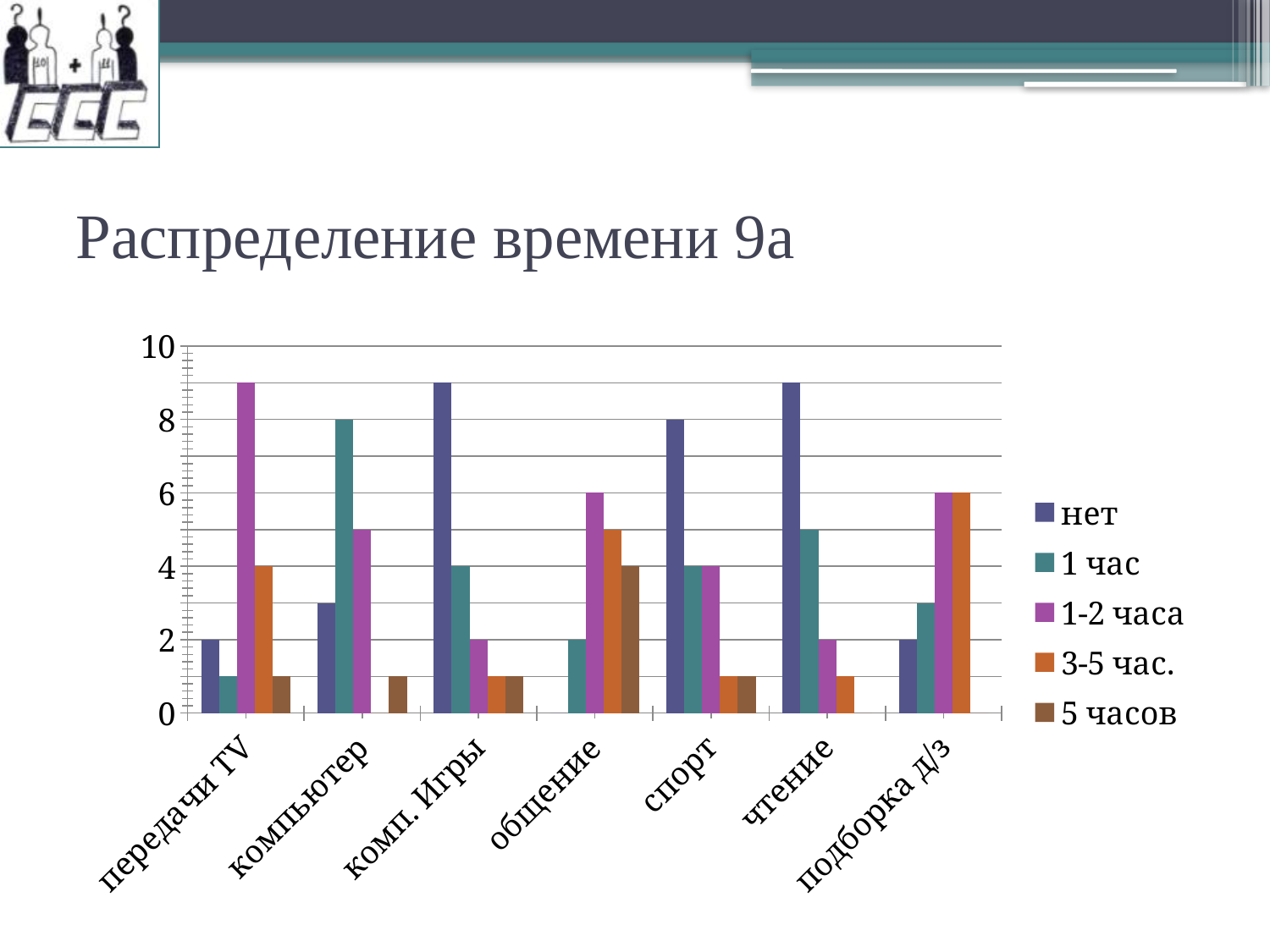
What is the title of the chart? Распределение времени 9а How many categories are shown along the x axis? 7 Which category has the highest "1 час" bar? компьютер For "общение", which is larger: the "1-2 часа" bar or the "5 часов" bar? 1-2 часа Is the value of the "нет" bar for "комп. Игры" greater or less than 8? greater Which category has the highest "5 часов" bar? общение Is the value of the "1-2 часа" bar for "передачи TV" greater or less than 8? greater What kind of chart is shown on the slide? bar chart What is the value of the "нет" bar for "спорт"? 8 How many series does the legend list? 5 What is the value of the "1 час" bar for "компьютер"? 8 What is the value of the "1-2 часа" bar for "общение"? 6